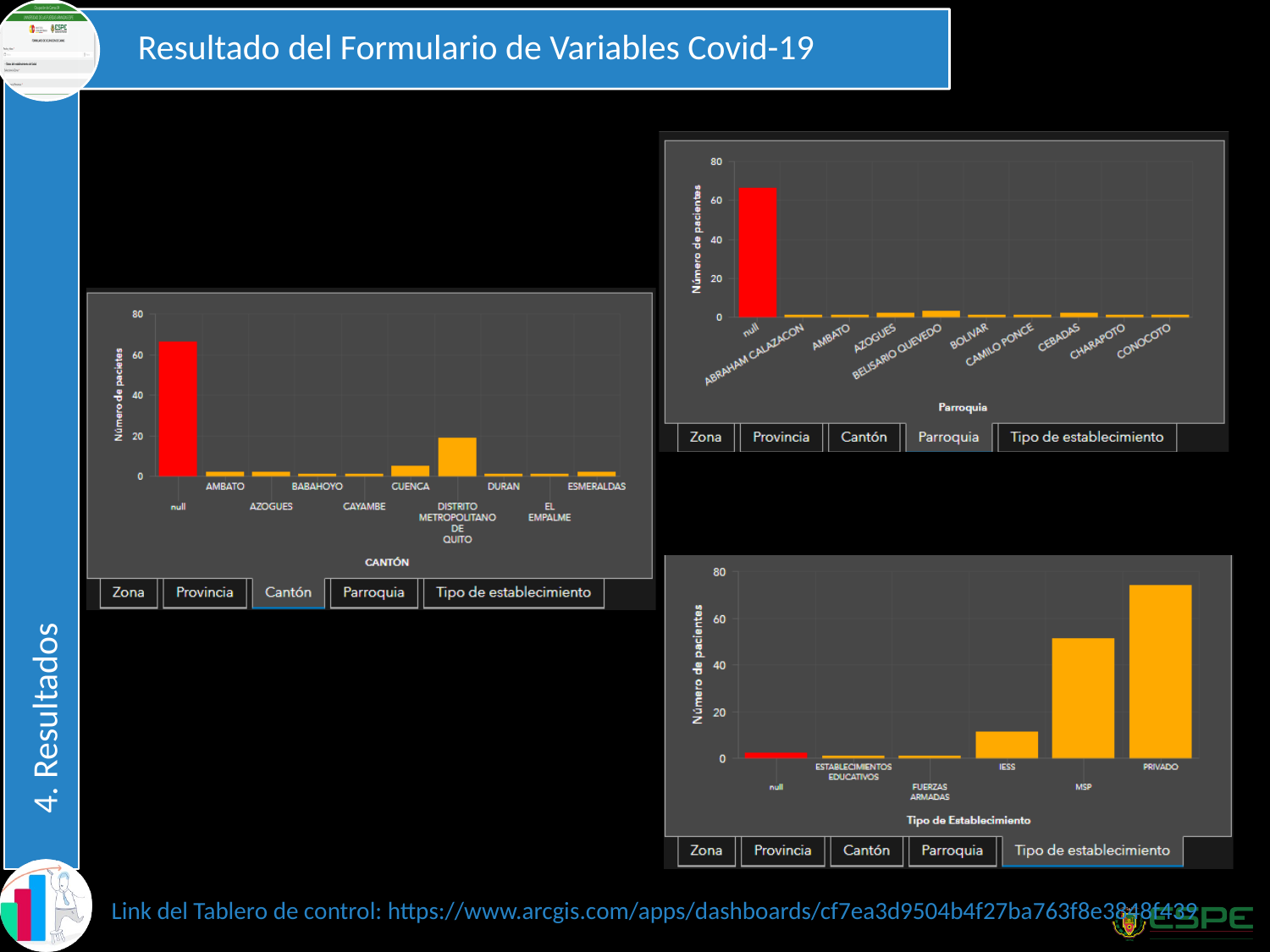
In the Tipo de Establecimiento chart at the bottom right, which is larger, MSP or IESS? MSP In the Cantón chart on the left, which category has the highest number of patients? null In the Tipo de Establecimiento chart at the bottom right, which category has the highest number of patients? PRIVADO In the Parroquia chart at the top right, which category has the highest number of patients? null In the Tipo de Establecimiento chart at the bottom right, is the value for MSP greater or less than 40? greater What kind of chart is the Tipo de Establecimiento chart at the bottom right? bar chart In the Cantón chart on the left, how many categories are shown on the x axis? 10 In the Cantón chart on the left, is the value for null greater or less than 60? greater In the Cantón chart on the left, is the value for DISTRITO METROPOLITANO DE QUITO greater or less than 40? less In the Tipo de Establecimiento chart at the bottom right, how many categories are shown on the x axis? 6 In the Cantón chart on the left, which is larger, CUENCA or DISTRITO METROPOLITANO DE QUITO? DISTRITO METROPOLITANO DE QUITO